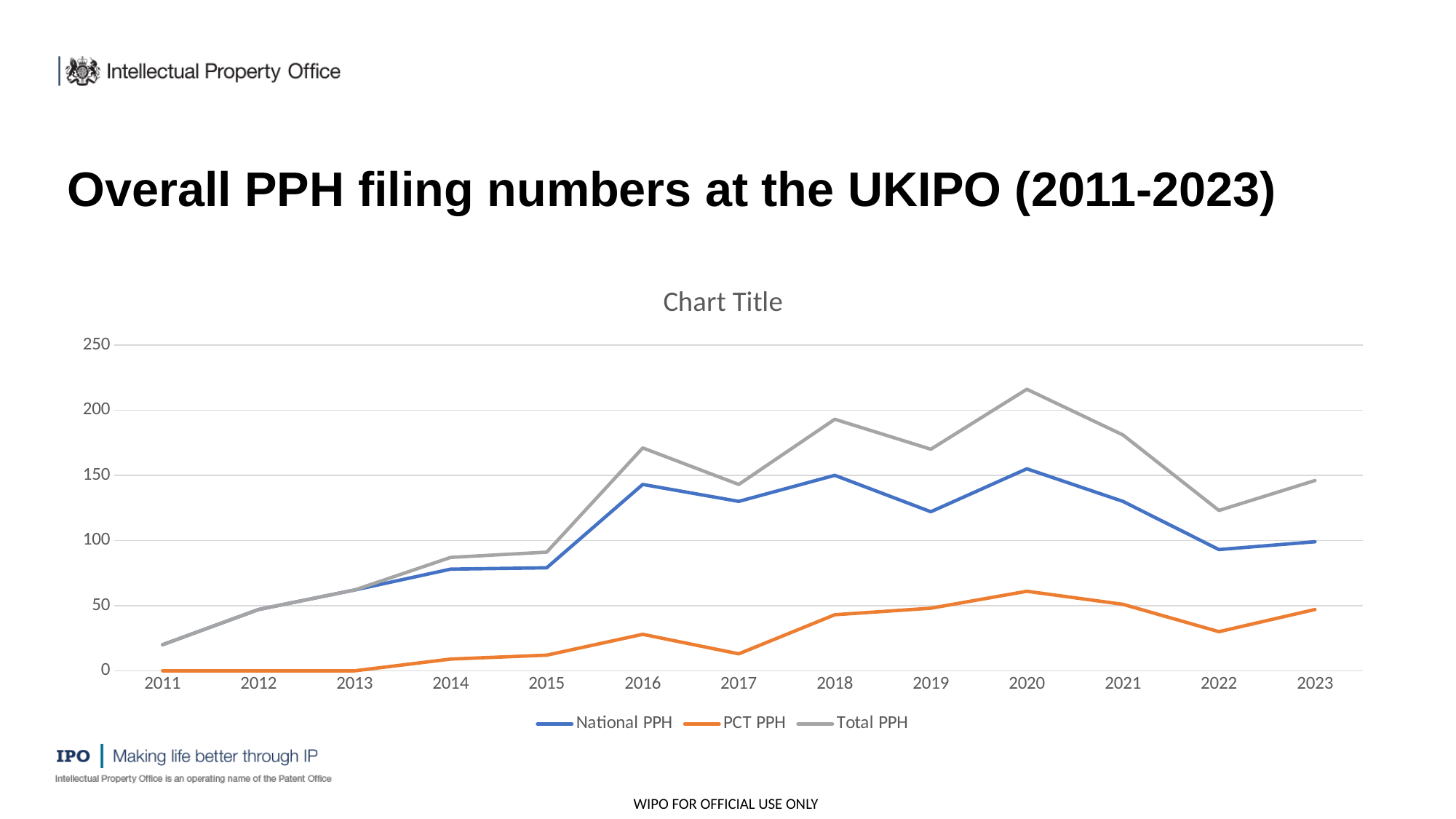
What are the three series named in the legend? National PPH, PCT PPH, Total PPH In which year does the PCT PPH series reach its highest value? 2020 How many series does the legend list? 3 In which year does the Total PPH series reach its highest value? 2020 Is the National PPH value for 2022 greater or less than 100? less In which year is the Total PPH series at its lowest value? 2011 What kind of chart is shown on the slide? line chart How many years are plotted along the x axis? 13 Is the Total PPH value for 2020 greater or less than 200? greater Does the Total PPH series rise or fall from 2011 to 2016? rise Which year has the larger Total PPH value, 2018 or 2019? 2018